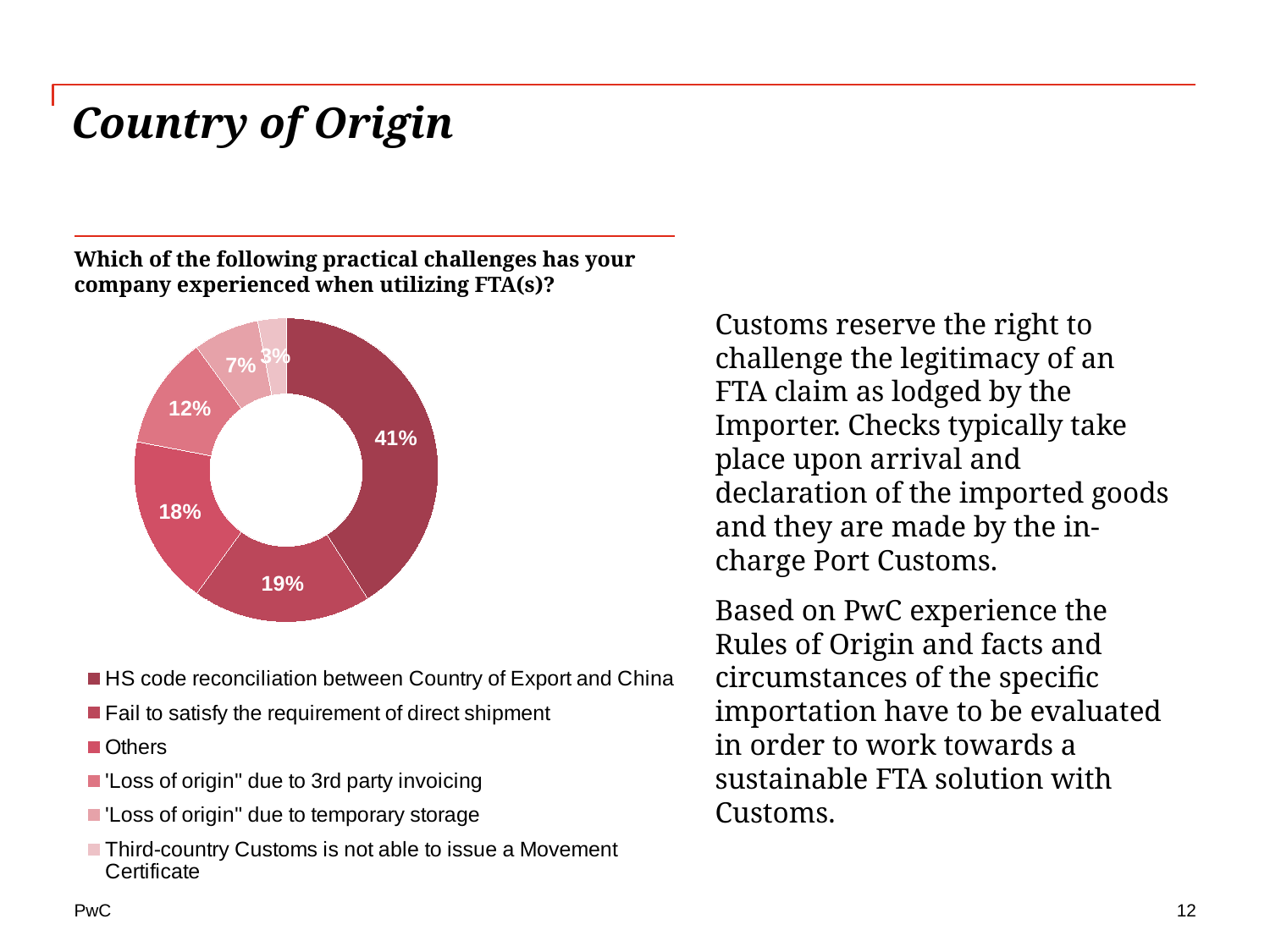
What percentage is shown for 'Others'? 18% Which is larger: the share for 'Loss of origin' due to 3rd party invoicing or the share for 'Loss of origin' due to temporary storage? 'Loss of origin' due to 3rd party invoicing Which practical challenge has the largest share of the pie? HS code reconciliation between Country of Export and China How many categories does the legend of the pie chart list? 6 What share is attributed to 'Loss of origin' due to 3rd party invoicing? 12% Which practical challenge has the smallest share of the pie? Third-country Customs is not able to issue a Movement Certificate What question is the pie chart answering, according to the heading above it? Which of the following practical challenges has your company experienced when utilizing FTA(s)? What is the difference in percentage points between the HS code reconciliation slice and the 'Fail to satisfy the requirement of direct shipment' slice? 22 percentage points What percentage is shown for 'Third-country Customs is not able to issue a Movement Certificate'? 3% What share of respondents cited HS code reconciliation between Country of Export and China as a practical challenge? 41% What percentage is shown for 'Fail to satisfy the requirement of direct shipment'? 19% What kind of chart is shown on the slide? Pie chart (donut)